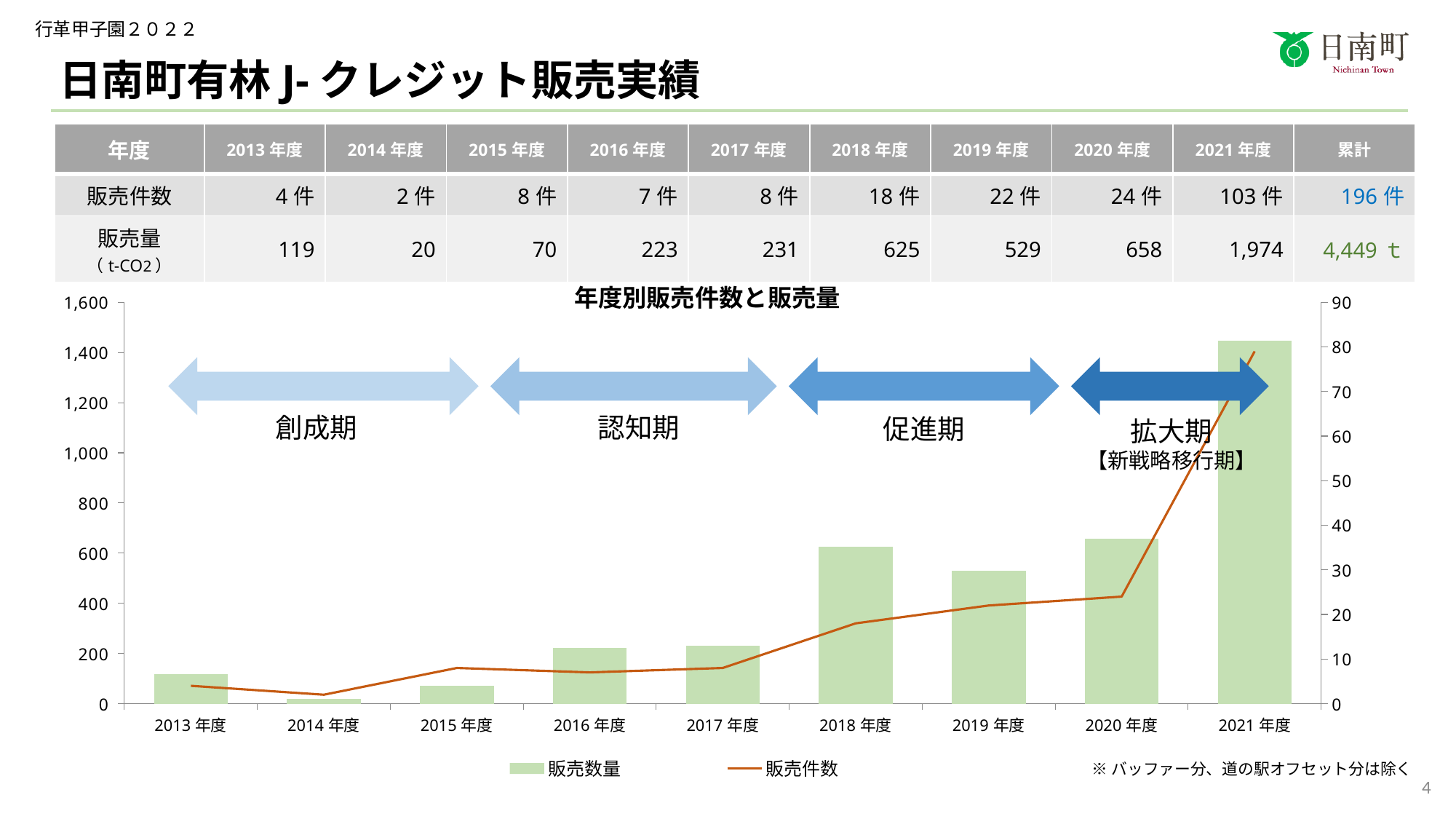
What are the two legend entries of the chart? 販売数量 and 販売件数 Is the 販売数量 bar for 2021年度 greater or less than 1,200? greater Which is larger, the 販売数量 bar for 2018年度 or for 2019年度? 2018年度 Is the 販売件数 line value for 2020年度 greater or less than 30 on the right axis? less How many fiscal years are shown on the x axis of the chart? 9 Does the 販売件数 line generally rise or fall from 2013年度 to 2021年度? rise How many series does the chart legend list? 2 Is the 販売数量 bar for 2016年度 greater or less than 400? less Which fiscal year has the shortest 販売数量 bar? 2014年度 What kind of chart is shown on the slide? A combination bar and line chart What is the title of the chart? 年度別販売件数と販売量 Which fiscal year has the tallest 販売数量 bar? 2021年度